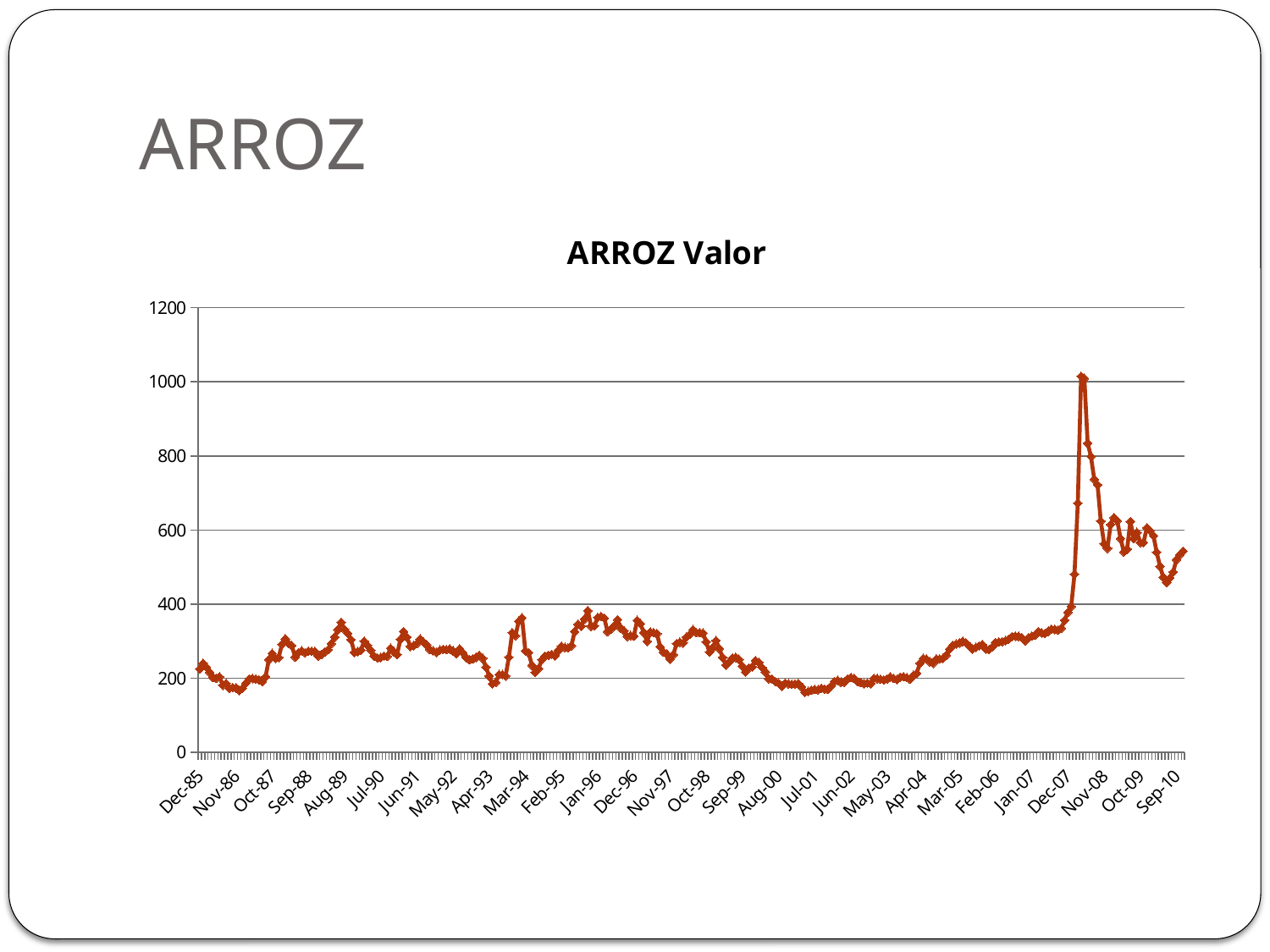
Is the peak value of the line greater or less than 800? greater Is the value at Dec-07 greater or less than 600? less Is the value at Aug-89 greater or less than 400? less What is the highest value shown on the vertical axis of the chart? 1200 What kind of chart is shown on the slide? line chart What is the title of the chart? ARROZ Valor Does the peak of the line occur before or after Dec-07? after Does the line generally rise or fall between Jan-96 and Jul-01? fall Which is larger, the value at Sep-10 or the value at Dec-85? Sep-10 Does the line generally rise or fall between Jul-01 and Dec-07? rise